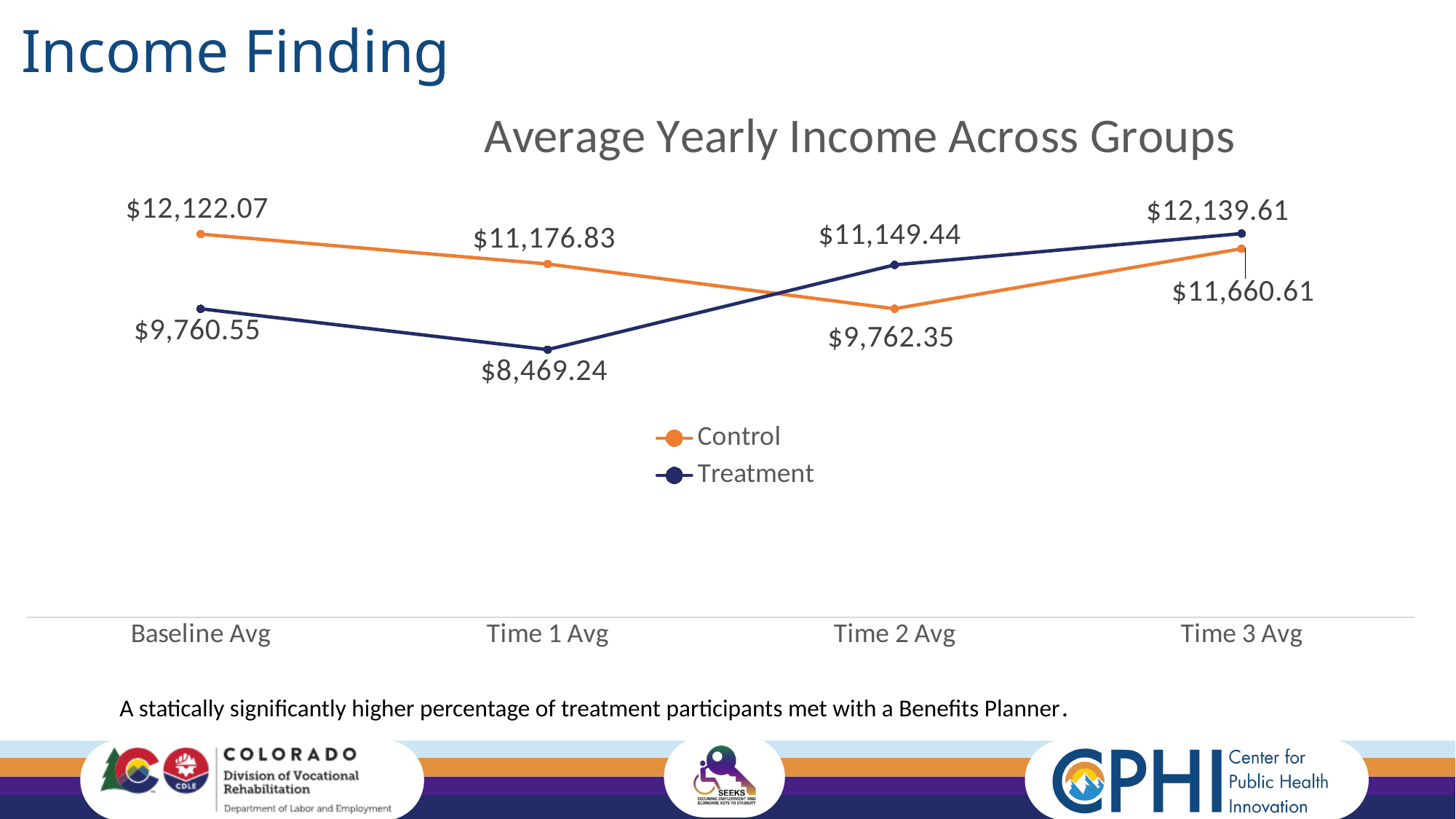
What is the Treatment group's value at Time 3 Avg? $12,139.61 What kind of chart is shown on the slide? Line chart What is the difference between the Treatment and Control values at Time 3 Avg? $479.00 At which time point is the Control group's average yearly income lowest? Time 2 Avg At which time point is the Treatment group's average yearly income highest? Time 3 Avg What is the difference between the Control and Treatment values at Baseline Avg? $2,361.52 How many series does the legend list? 2 What is the Treatment group's average yearly income at Time 1 Avg? $8,469.24 What is the Control group's value at Time 2 Avg? $9,762.35 At Time 2 Avg, which group has the higher average yearly income, Control or Treatment? Treatment What is the Control group's average yearly income at Baseline Avg? $12,122.07 How many time points are shown on the x axis? 4